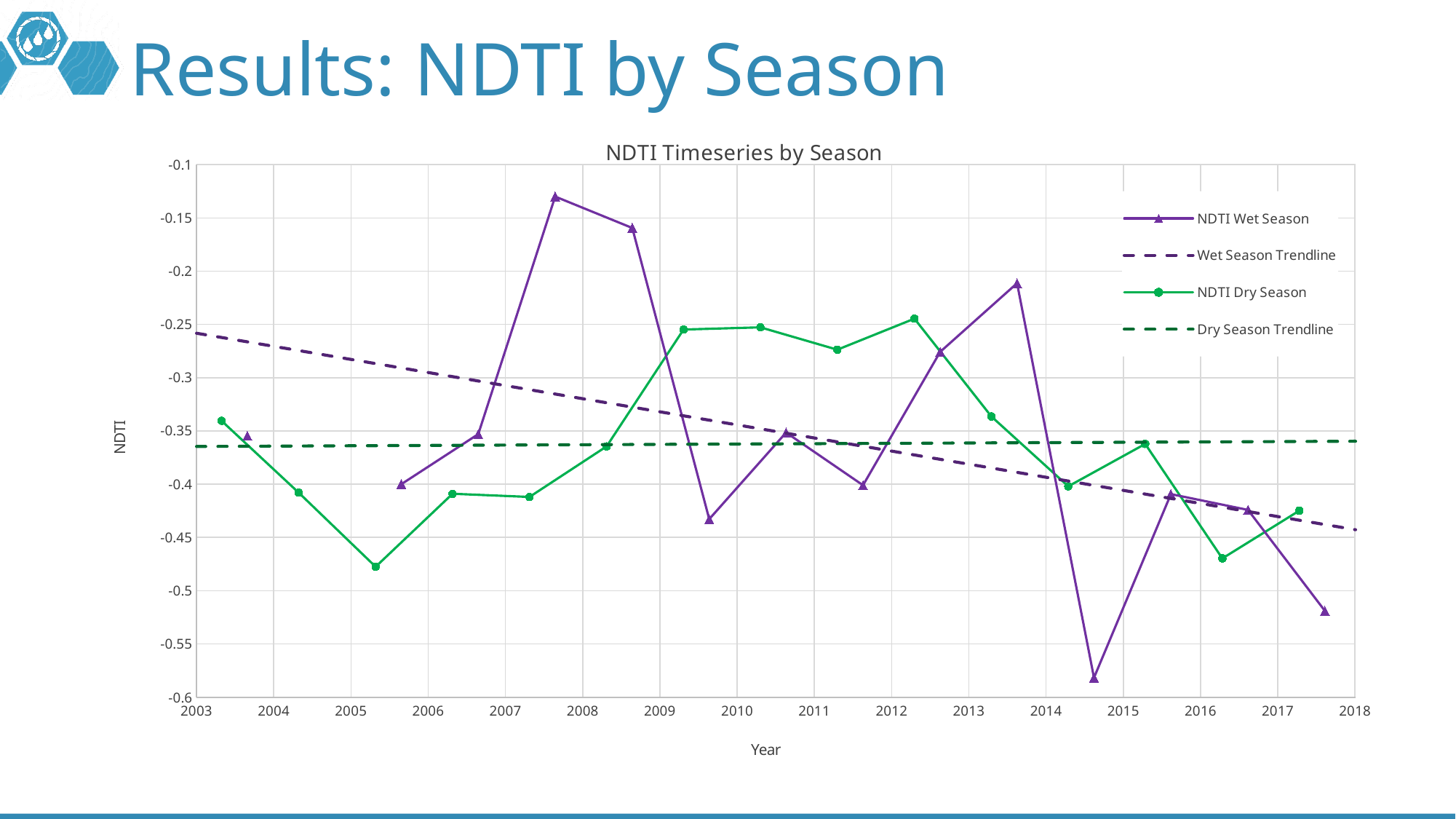
Is the highest NDTI Dry Season value greater or less than -0.3? greater What is the title of the chart? NDTI Timeseries by Season How many data points are plotted for the NDTI Dry Season series? 15 Which series reaches the lower minimum value, NDTI Wet Season or NDTI Dry Season? NDTI Wet Season Does the Wet Season Trendline rise or fall from 2003 to 2018? fall Is the highest NDTI Wet Season value greater or less than -0.15? greater What kind of chart is shown on the slide? line chart Which series reaches the higher peak value, NDTI Wet Season or NDTI Dry Season? NDTI Wet Season Is the lowest NDTI Wet Season value greater or less than -0.55? less How many series does the legend list? 4 What is the label on the y axis of the chart? NDTI